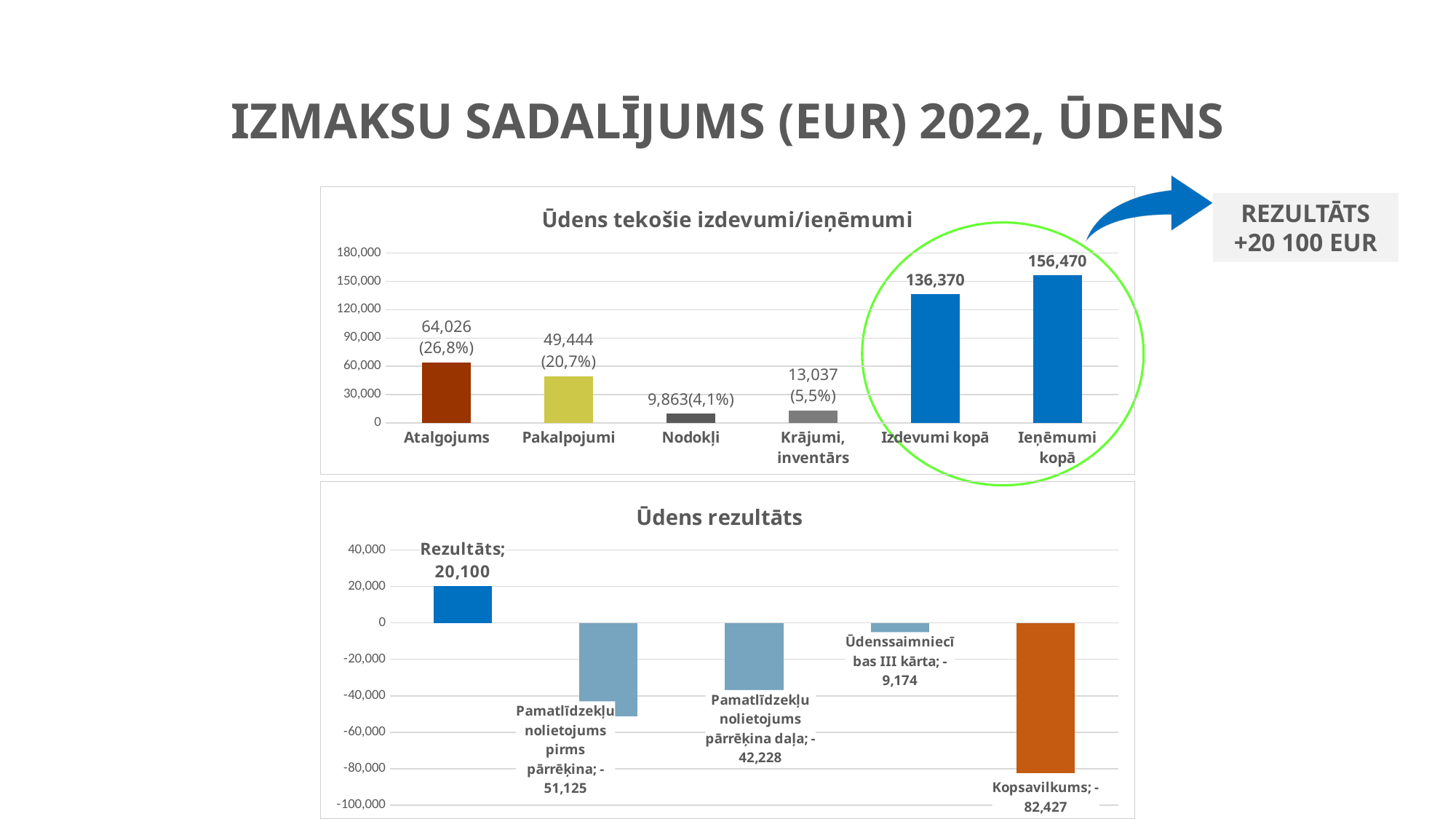
In the chart titled "Ūdens tekošie izdevumi/ieņēmumi", what is the value for Atalgojums? 64,026 In the chart titled "Ūdens rezultāts", which bar has the lowest value? Kopsavilkums In the chart titled "Ūdens tekošie izdevumi/ieņēmumi", which is larger: Krājumi, inventārs or Nodokļi? Krājumi, inventārs In the chart titled "Ūdens tekošie izdevumi/ieņēmumi", what percentage is shown for Pakalpojumi? 20,7% In the chart titled "Ūdens tekošie izdevumi/ieņēmumi", what is the value for Ieņēmumu kopā? 156,470 In the chart titled "Ūdens rezultāts", what is the difference between Pamatlīdzekļu nolietojums pirms pārrēķina and Pamatlīdzekļu nolietojums pārrēķina daļa? 8,897 In the chart titled "Ūdens rezultāts", what is the value for Kopsavilkums? -82,427 In the chart titled "Ūdens tekošie izdevumi/ieņēmumi", which category has the lowest value? Nodokļi In the chart titled "Ūdens rezultāts", what is the value for Rezultāts? 20,100 What type of chart is the chart titled "Ūdens rezultāts"? Bar chart In the chart titled "Ūdens tekošie izdevumi/ieņēmumi", how many categories are shown on the x axis? 6 In the chart titled "Ūdens tekošie izdevumi/ieņēmumi", what is the difference between Ieņēmumu kopā and Izdevumi kopā? 20,100